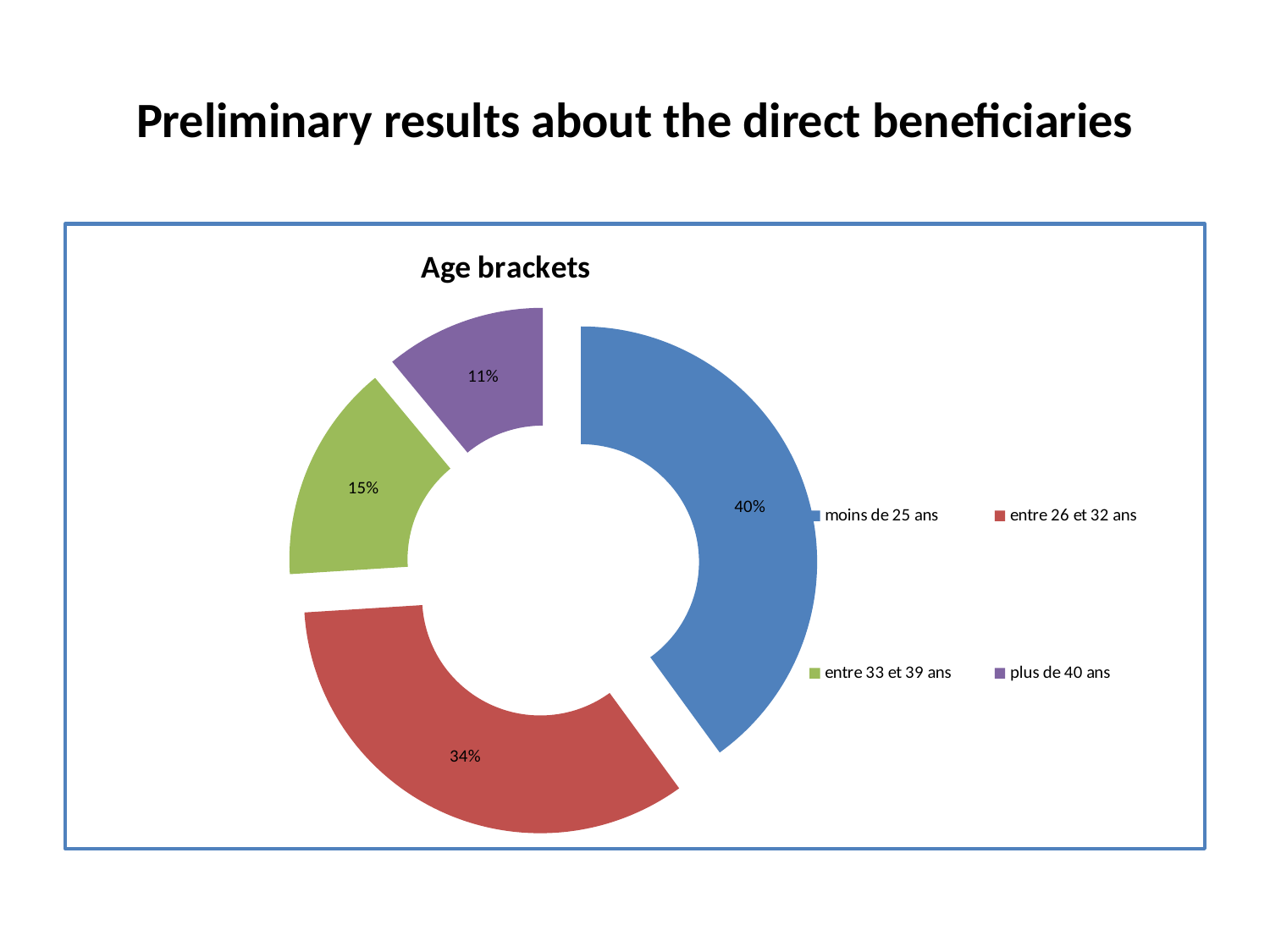
What kind of chart is shown on the slide? Doughnut (pie) chart What share of the chart does 'plus de 40 ans' represent? 11% How many age brackets are shown in the chart? 4 What colour is the slice for 'entre 26 et 32 ans'? Red Which age bracket has the largest share? moins de 25 ans What share of the chart does 'moins de 25 ans' represent? 40% What is the difference in percentage points between 'moins de 25 ans' and 'entre 26 et 32 ans'? 6 What is the title of the chart? Age brackets Which is larger, the share for 'entre 33 et 39 ans' or for 'plus de 40 ans'? entre 33 et 39 ans Which age bracket has the smallest share? plus de 40 ans What share of the chart does 'entre 33 et 39 ans' represent? 15% What share of the chart does 'entre 26 et 32 ans' represent? 34%